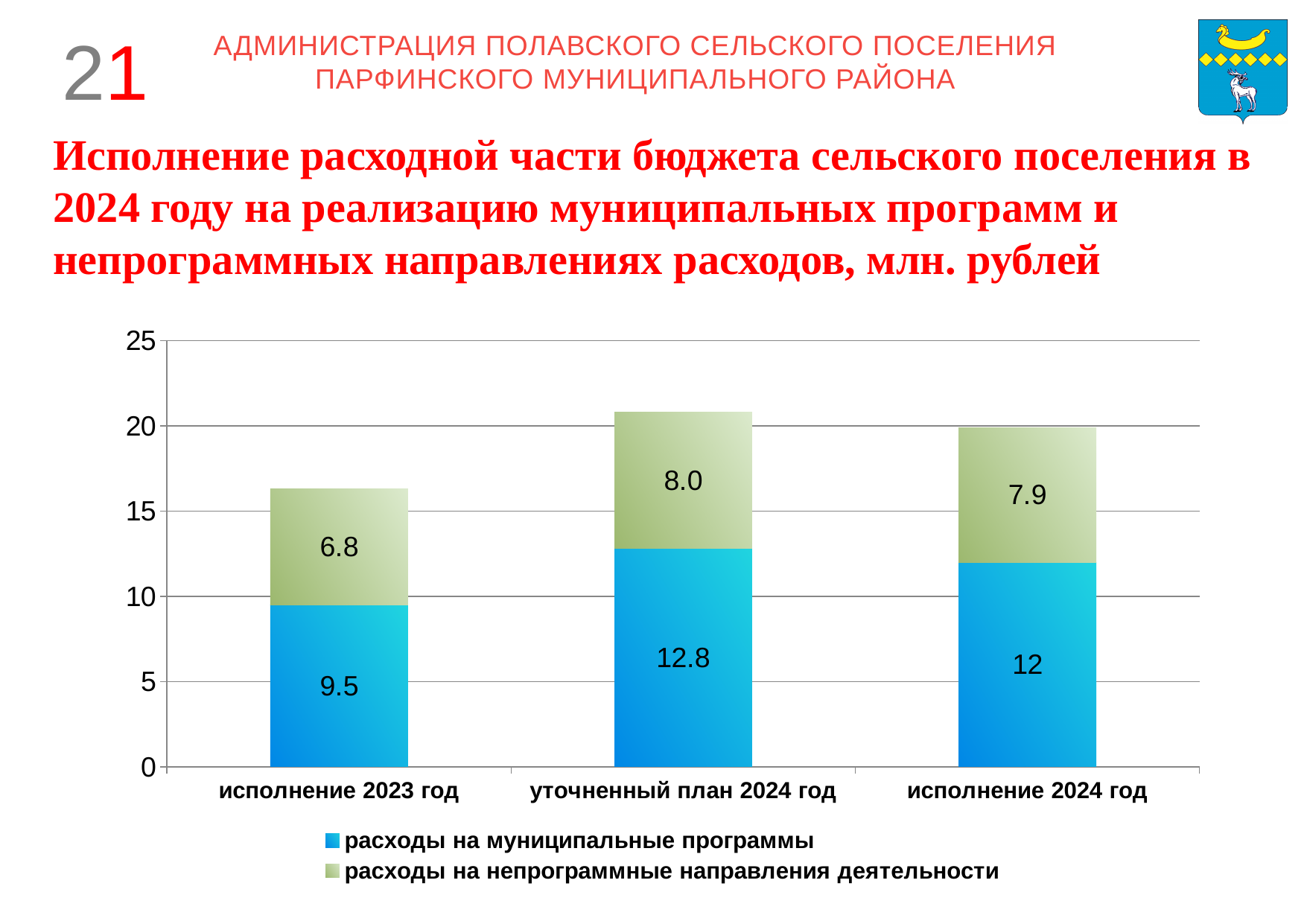
What type of chart is shown on the slide? stacked bar chart What is the value of 'расходы на непрограммные направления деятельности' for 'уточненный план 2024 год'? 8.0 What is the total of the stacked bar for 'исполнение 2024 год'? 19.9 Which series is shown in blue in the legend? расходы на муниципальные программы What is the difference between 'расходы на муниципальные программы' for 'уточненный план 2024 год' and for 'исполнение 2024 год'? 0.8 How many series does the legend list? 2 Which is larger: 'расходы на непрограммные направления деятельности' for 'исполнение 2023 год' or for 'исполнение 2024 год'? исполнение 2024 год Which category has the lowest value for 'расходы на непрограммные направления деятельности'? исполнение 2023 год What is the value of 'расходы на муниципальные программы' for 'исполнение 2023 год'? 9.5 How many categories are shown on the x axis of the chart? 3 Which category has the highest value for 'расходы на муниципальные программы'? уточненный план 2024 год What is the value of 'расходы на муниципальные программы' for 'исполнение 2024 год'? 12